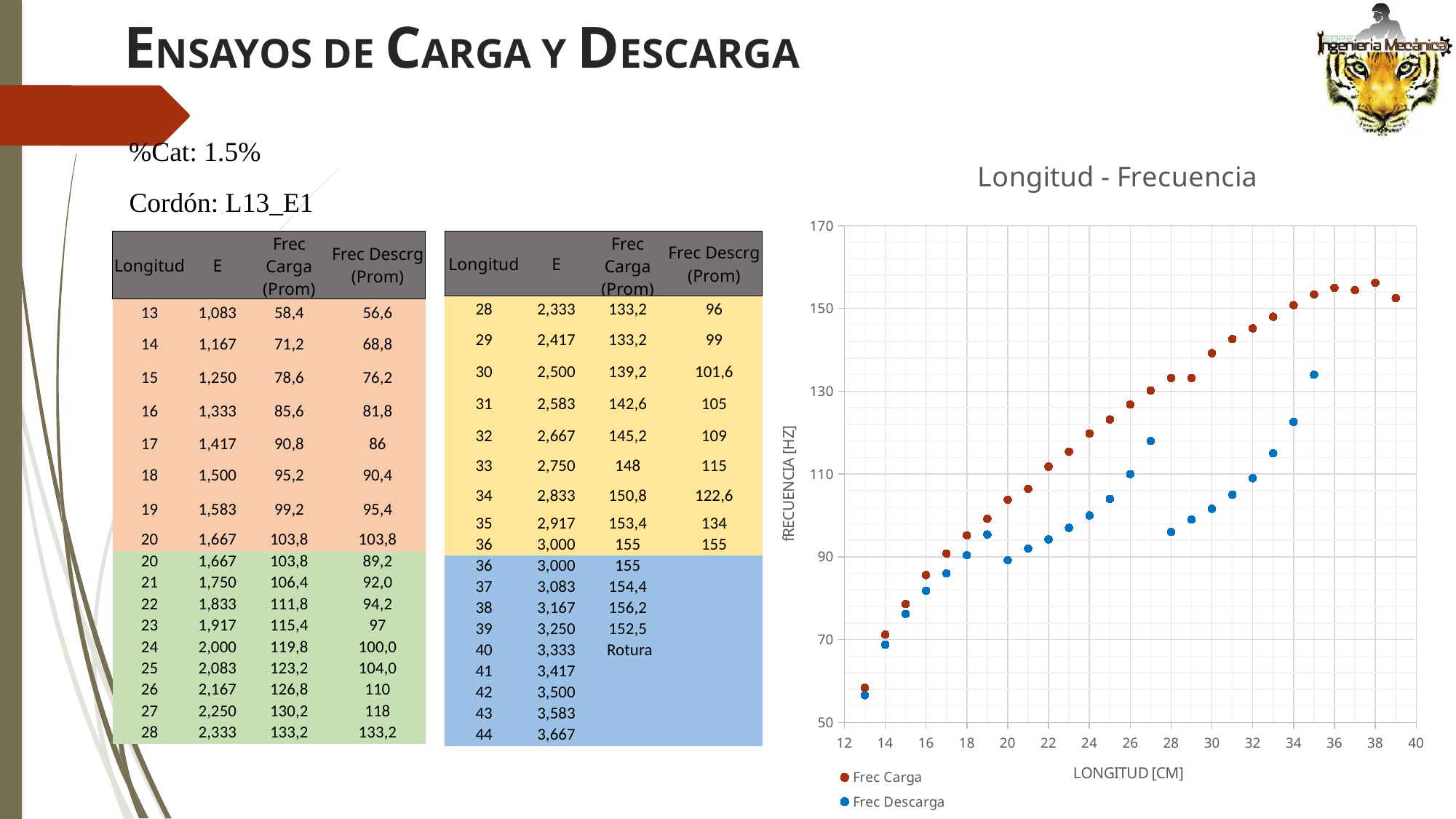
In the Longitud - Frecuencia chart, which series has the larger value at longitud 30, Frec Carga or Frec Descarga? Frec Carga In the Longitud - Frecuencia chart, is the Frec Carga value at longitud 38 greater or less than 150? greater What kind of chart is shown on the slide? scatter chart How many series does the legend of the Longitud - Frecuencia chart list? 2 What is the title of the chart on the slide? Longitud - Frecuencia In the Longitud - Frecuencia chart, at which longitud does the Frec Carga series reach its highest value? 38 In the Longitud - Frecuencia chart, do the Frec Carga values generally rise or fall as longitud increases? rise What is the label of the vertical axis of the chart? fRECUENCIA [HZ] In the Longitud - Frecuencia chart, is the Frec Carga value at longitud 13 greater or less than 70? less In the Longitud - Frecuencia chart, is the Frec Descarga value at longitud 35 greater or less than 130? greater In the Longitud - Frecuencia chart, at which longitud does the Frec Carga series have its lowest value? 13